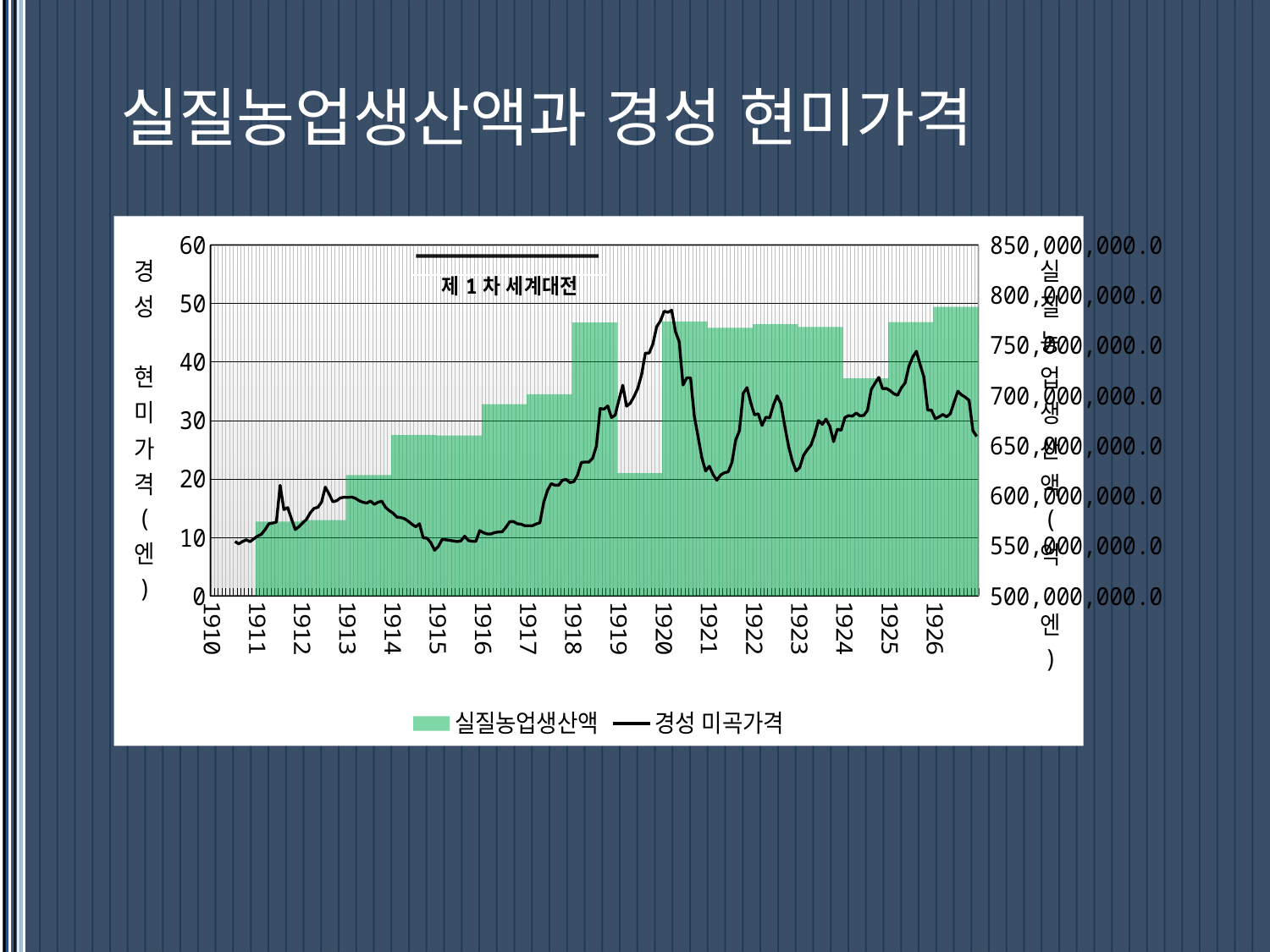
In which year does the 경성 미곡가격 line reach its highest point? 1920 What historical event is annotated above the chart between about 1914 and 1918? 제 1 차 세계대전 How many year labels are shown on the x axis? 17 What kind of chart is shown on the slide? bar and line chart How many series does the legend list? 2 Is the 실질농업생산액 value for 1911 greater or less than 600,000,000.0 on the right axis? less Which year has the larger 실질농업생산액 value, 1918 or 1919? 1918 Does the 실질농업생산액 series rise or fall from 1911 to 1918? rise Is the peak value of the 경성 미곡가격 line in 1920 greater or less than 40 on the left axis? greater Is the 경성 미곡가격 line value in 1915 greater or less than 20 on the left axis? less What are the two series named in the legend? 실질농업생산액 and 경성 미곡가격